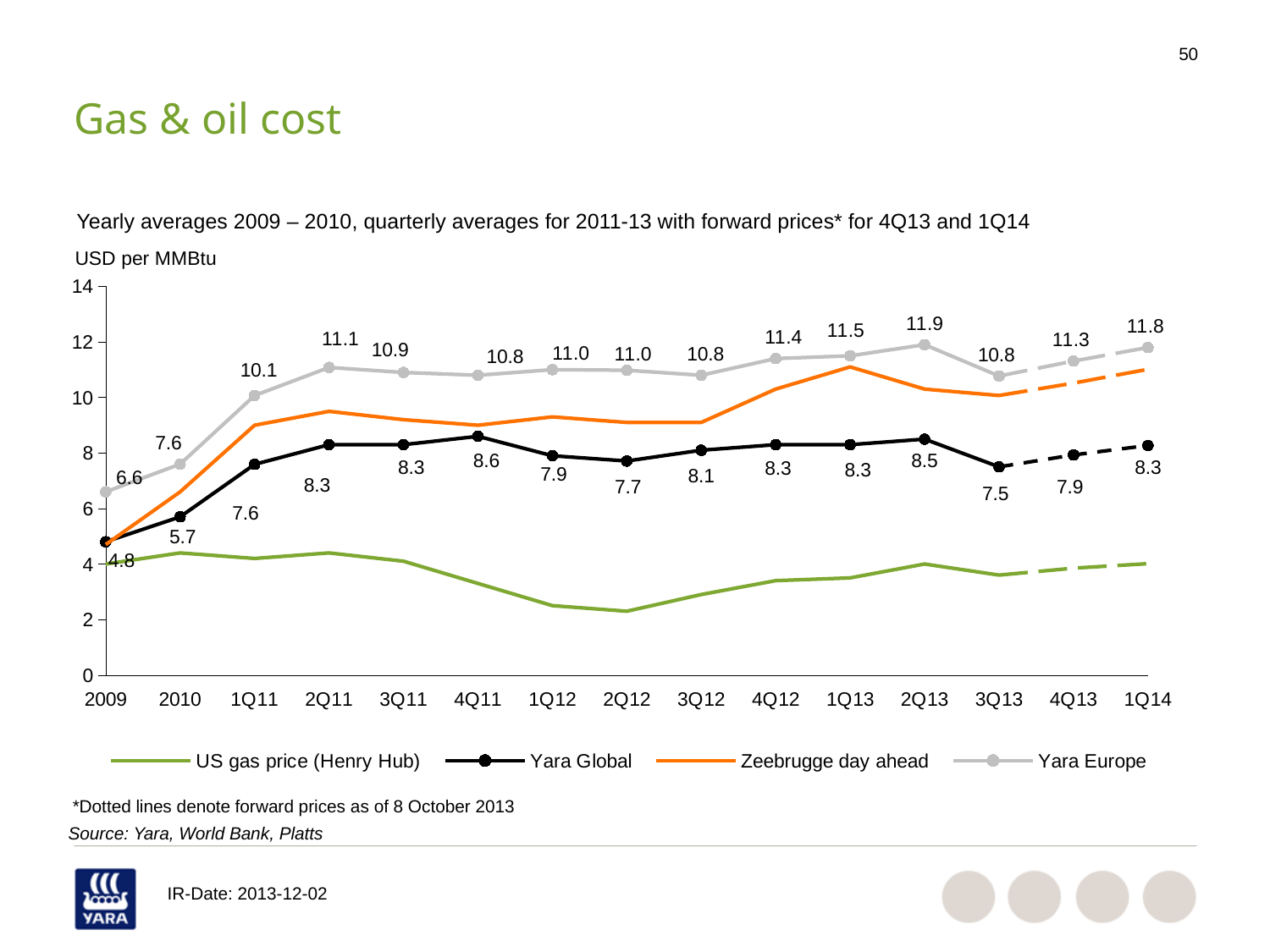
Is the US gas price (Henry Hub) value for 2Q12 greater or less than 4? less What is the Yara Global value for 4Q11? 8.6 Is the Zeebrugge day ahead value for 1Q13 greater or less than 10? greater How many series does the legend list? 4 What is the difference between the Yara Europe and Yara Global values in 2Q13? 3.4 What is the Yara Europe value for 1Q13? 11.5 What is the Yara Global forward price for 1Q14? 8.3 In which period is the Yara Global series at its lowest value? 2009 What kind of chart is shown on the slide? Line chart In which period does the Yara Europe series reach its highest value? 2Q13 Which is larger in 3Q13: the Yara Europe value or the Yara Global value? Yara Europe How many periods are shown on the x axis? 15